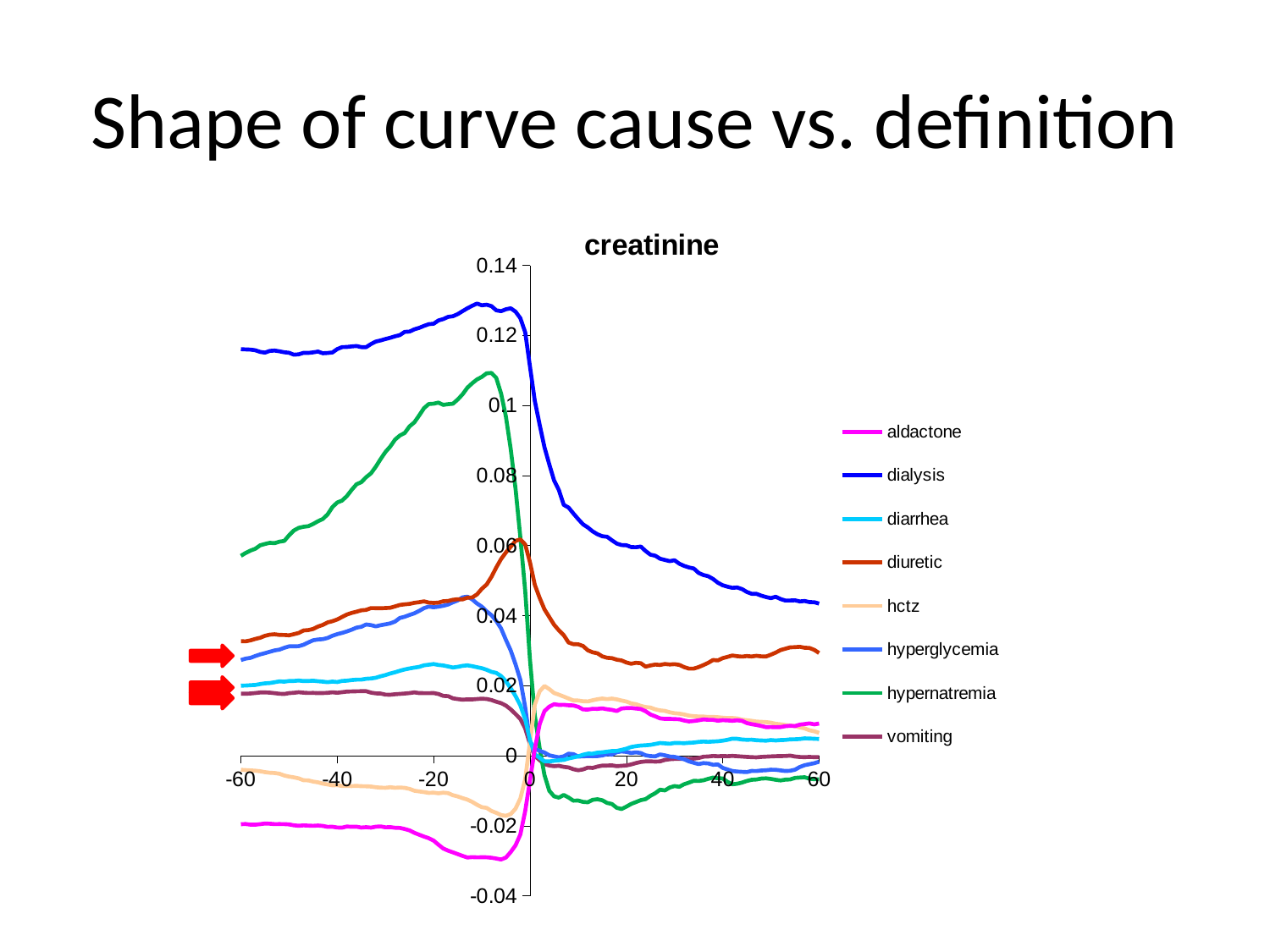
How many series does the legend of the chart list? 8 Which series has the lowest value at x = -60? aldactone Does the dialysis line rise or fall between x = 0 and x = 60? fall Which series reaches the highest peak on the chart? dialysis What is the title of the chart? creatinine What kind of chart is shown on the slide? line chart Is the value for hypernatremia at x = -60 greater or less than 0.08? less Is the value for hctz at x = -40 greater or less than 0? less At x = -60, which is larger: diuretic or diarrhea? diuretic Is the value for dialysis at x = -60 greater or less than 0.1? greater Which series has the lowest value at x = 20? hypernatremia Which series has the highest value at x = -60? dialysis